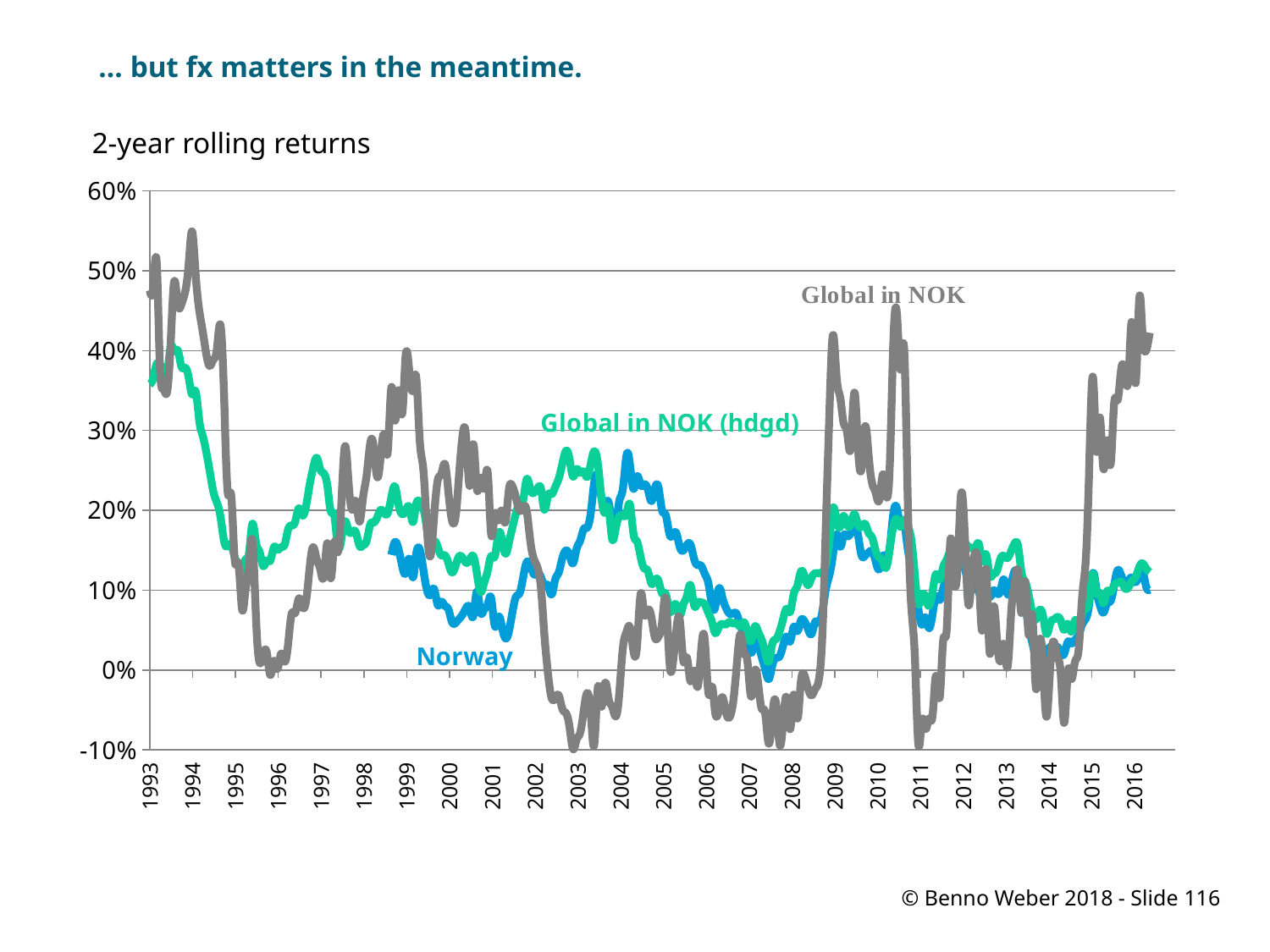
Is the value for Global in NOK at the start of 2003 greater or less than 0%? less How many data series are plotted on the chart? 3 Which series is drawn in grey? Global in NOK At the start of 2009, which series is higher: Global in NOK or Norway? Global in NOK Is the value for Norway in mid-2007 greater or less than 10%? less What kind of chart is shown on the slide? line chart What is the title of the chart? 2-year rolling returns Is the value for Global in NOK at the end of the series in 2016 greater or less than 30%? greater At the start of 1993, which series is higher: Global in NOK or Global in NOK (hdgd)? Global in NOK Does the Global in NOK (hdgd) series rise or fall between 1993 and 1995? fall